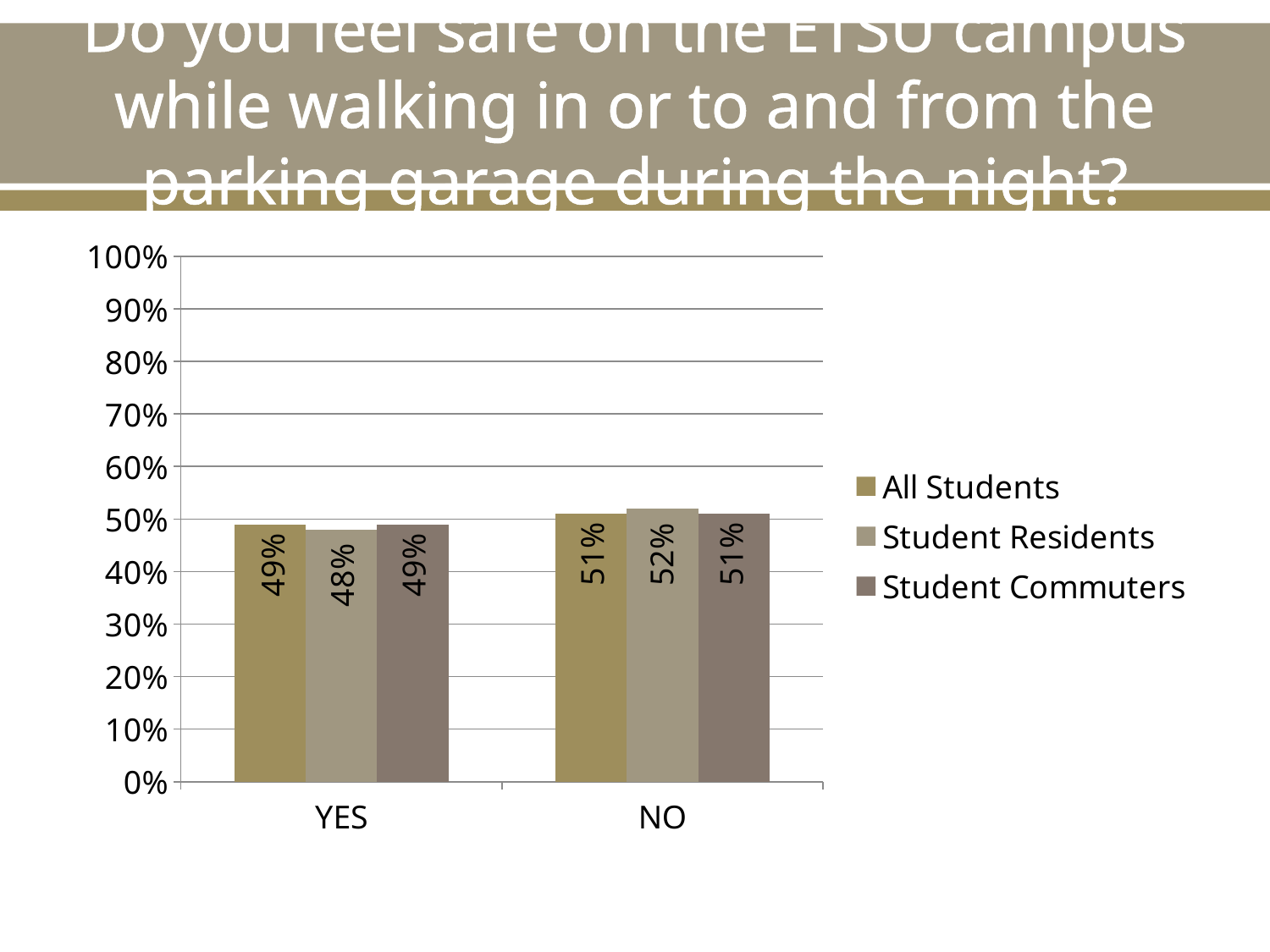
How many categories are shown on the x axis? 2 What is the difference between the NO and YES percentages for Student Residents? 4% What percentage of All Students answered YES? 49% What are the two categories on the x axis? YES and NO What percentage of Student Commuters answered YES? 49% What kind of chart is shown on the slide? Bar chart Is the value for Student Residents answering NO greater or less than 50%? greater How many series does the legend list? 3 What percentage of Student Residents answered NO? 52% Is the value for Student Residents answering YES greater or less than 50%? less What is the difference between the NO and YES percentages for All Students? 2% What percentage of Student Residents answered YES? 48%